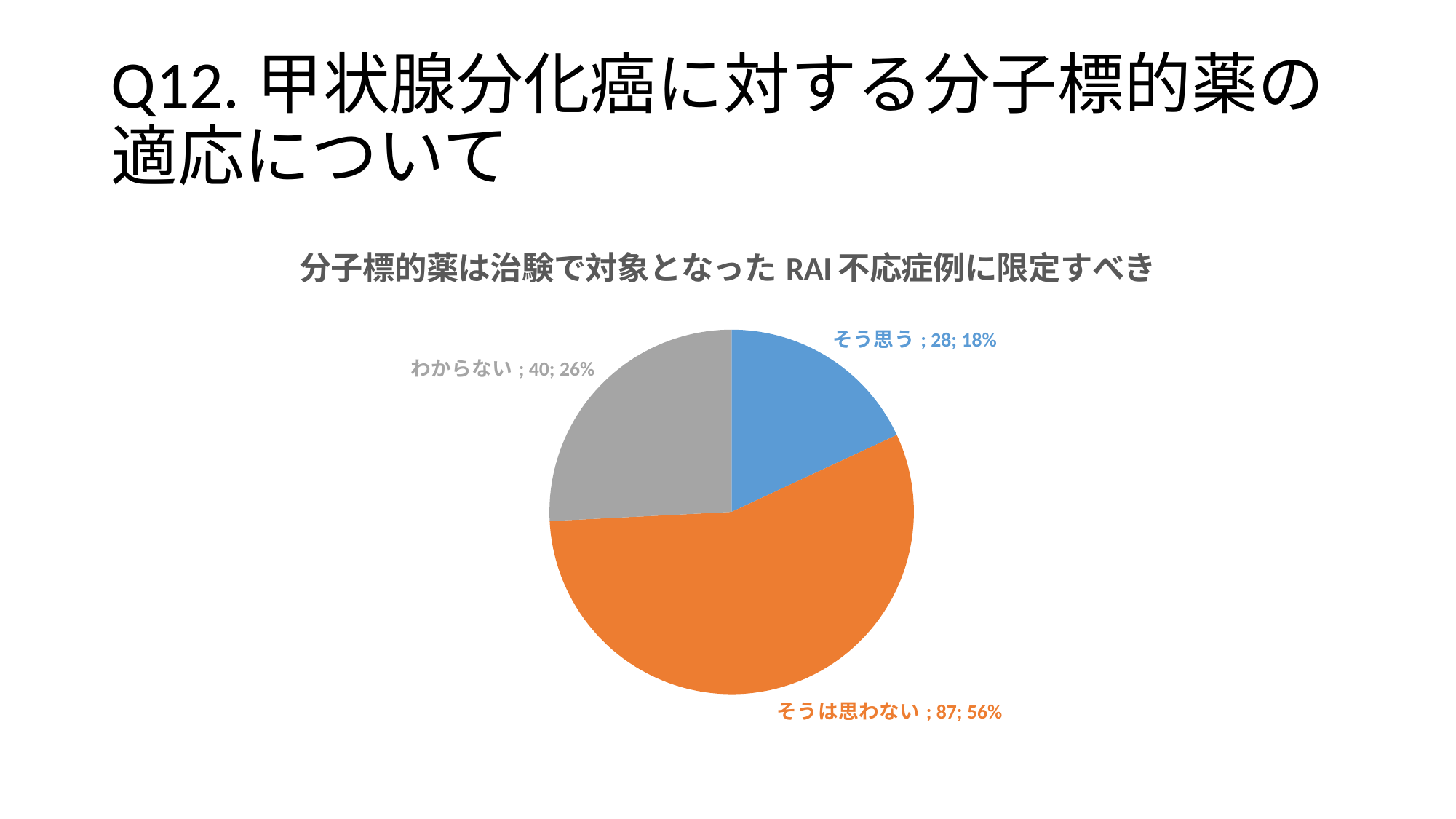
What share of the pie does そうは思わない represent? 56% Which category has the largest slice? そうは思わない How many slices does the pie chart have? 3 How many respondents answered そう思う? 28 What kind of chart is shown on the slide? pie chart Which category has the smallest slice? そう思う How many respondents answered わからない? 40 What share of the pie does わからない represent? 26% What is the chart's title? 分子標的薬は治験で対象となった RAI 不応症例に限定すべき How many respondents answered そうは思わない? 87 Which slice is larger, わからない or そう思う? わからない What is the difference in count between そうは思わない and そう思う? 59